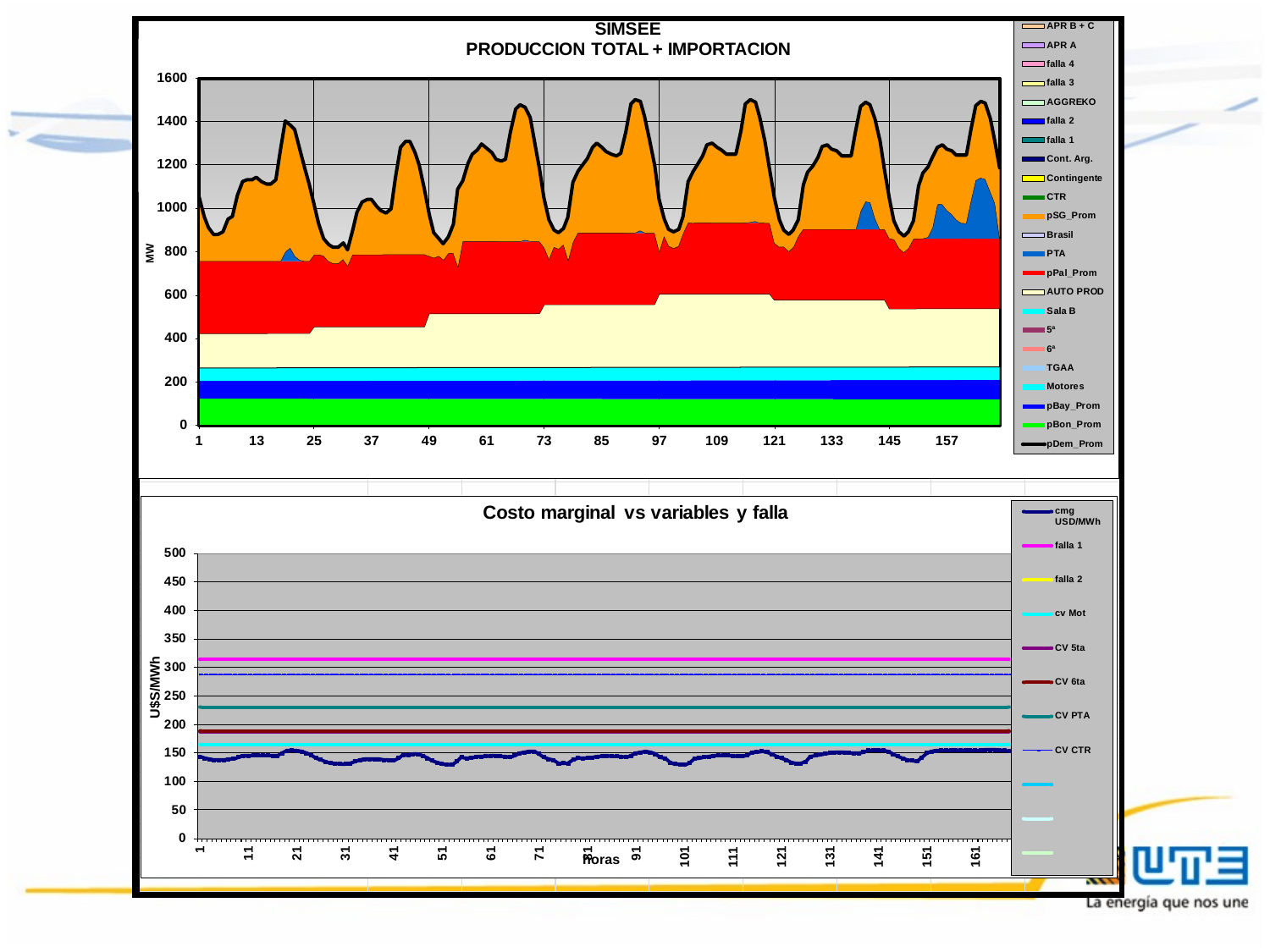
How many series does the legend of the top chart, SIMSEE PRODUCCION TOTAL + IMPORTACION, list? 23 In the top chart, SIMSEE PRODUCCION TOTAL + IMPORTACION, is the top of the pBon_Prom area greater or less than 200? less In the bottom chart, Costo marginal vs variables y falla, is the value of the CV 6ta line greater or less than 200? less In the bottom chart, Costo marginal vs variables y falla, does the cmg USD/MWh line stay greater or less than 200 throughout? less In the bottom chart, Costo marginal vs variables y falla, is the falla 1 line higher or lower than the CV PTA line? higher What is the title of the top chart? SIMSEE PRODUCCION TOTAL + IMPORTACION What kind of chart is the bottom chart, Costo marginal vs variables y falla? line chart What is the title of the bottom chart? Costo marginal vs variables y falla What kind of chart is the top chart, SIMSEE PRODUCCION TOTAL + IMPORTACION? stacked area chart